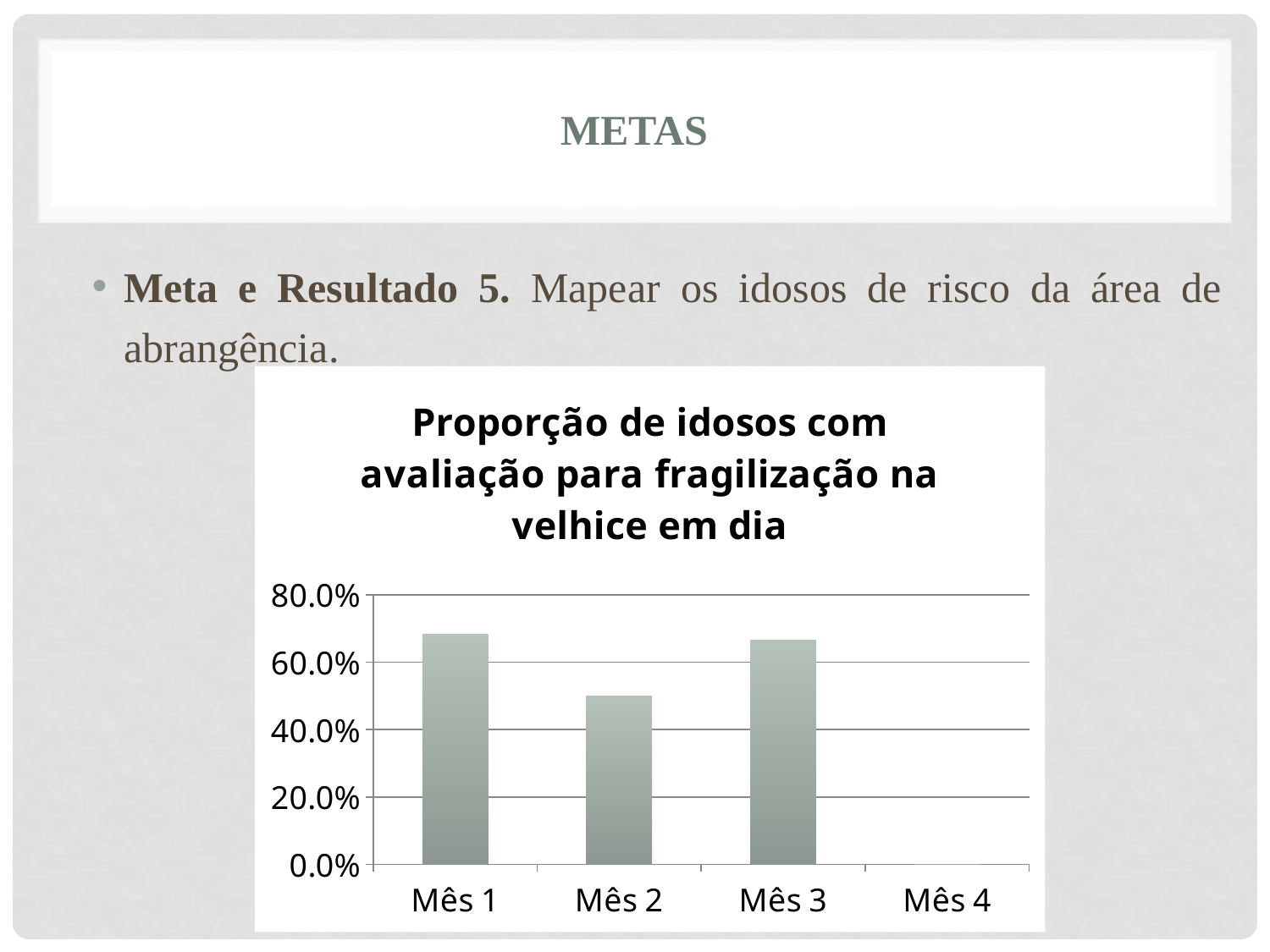
What kind of chart is shown on the slide? bar chart What is the highest value shown on the y axis of the chart? 80.0% What is the title of the chart? Proporção de idosos com avaliação para fragilização na velhice em dia Is the value for Mês 1 greater or less than 80.0%? less Which is larger, the value for Mês 1 or the value for Mês 2? Mês 1 Is the value for Mês 1 greater or less than 60.0%? greater Is the value for Mês 2 greater or less than 60.0%? less Which category has the lowest value in the chart? Mês 4 How many categories are shown on the x axis of the chart? 4 What is the value for Mês 4? 0.0%